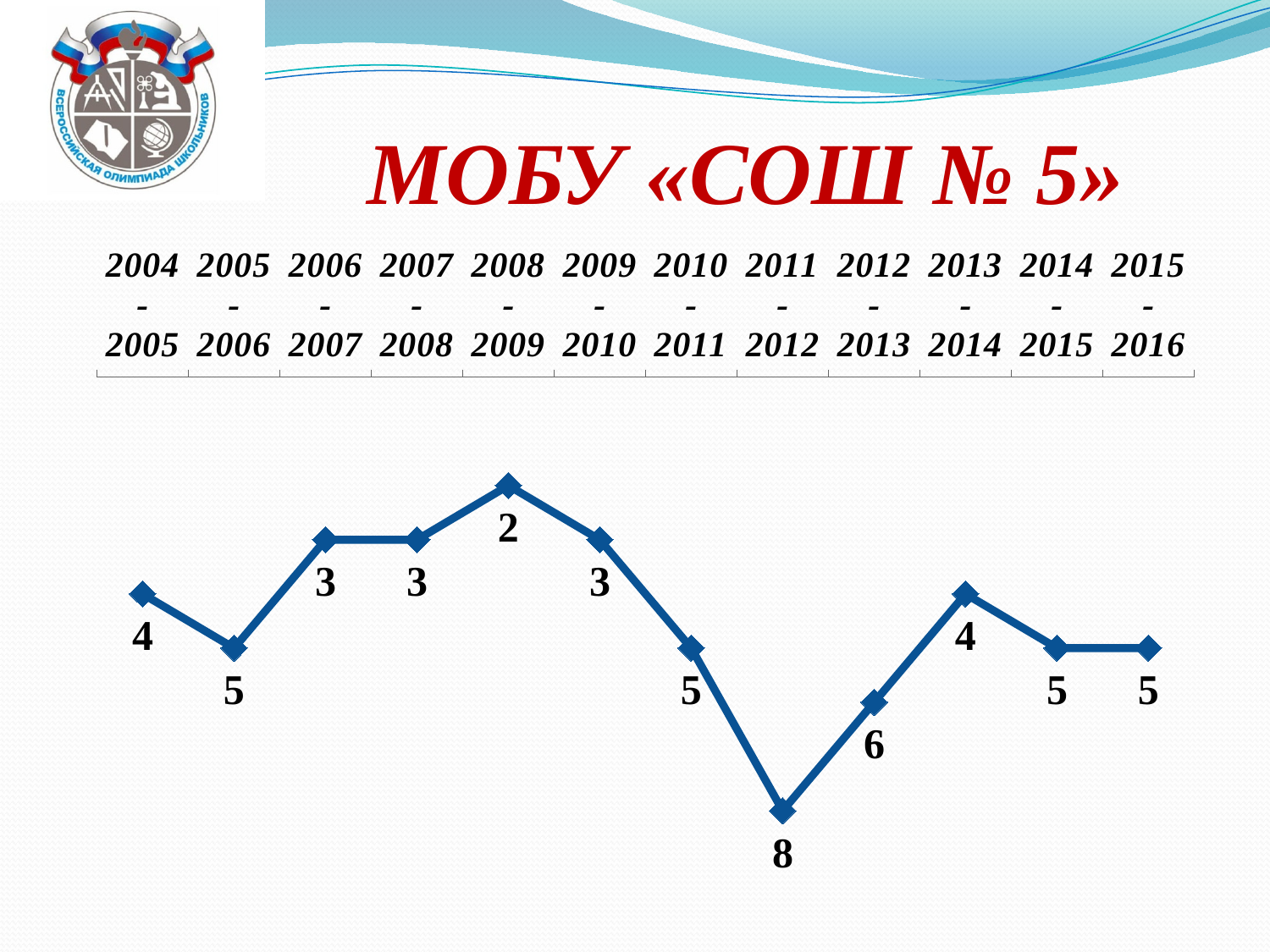
What is the difference between the values for 2011-2012 and 2008-2009? 6 Which period has the smallest value? 2008-2009 What is the title of the slide containing the chart? МОБУ «СОШ № 5» What is the value for 2011-2012? 8 How many data points are plotted on the chart? 12 What is the value for 2012-2013? 6 What is the difference between the values for 2012-2013 and 2013-2014? 2 What is the value for 2004-2005? 4 What type of chart is shown on the slide? line chart Which is larger, the value for 2005-2006 or the value for 2006-2007? 2005-2006 What is the value for 2008-2009? 2 Which period has the largest value? 2011-2012